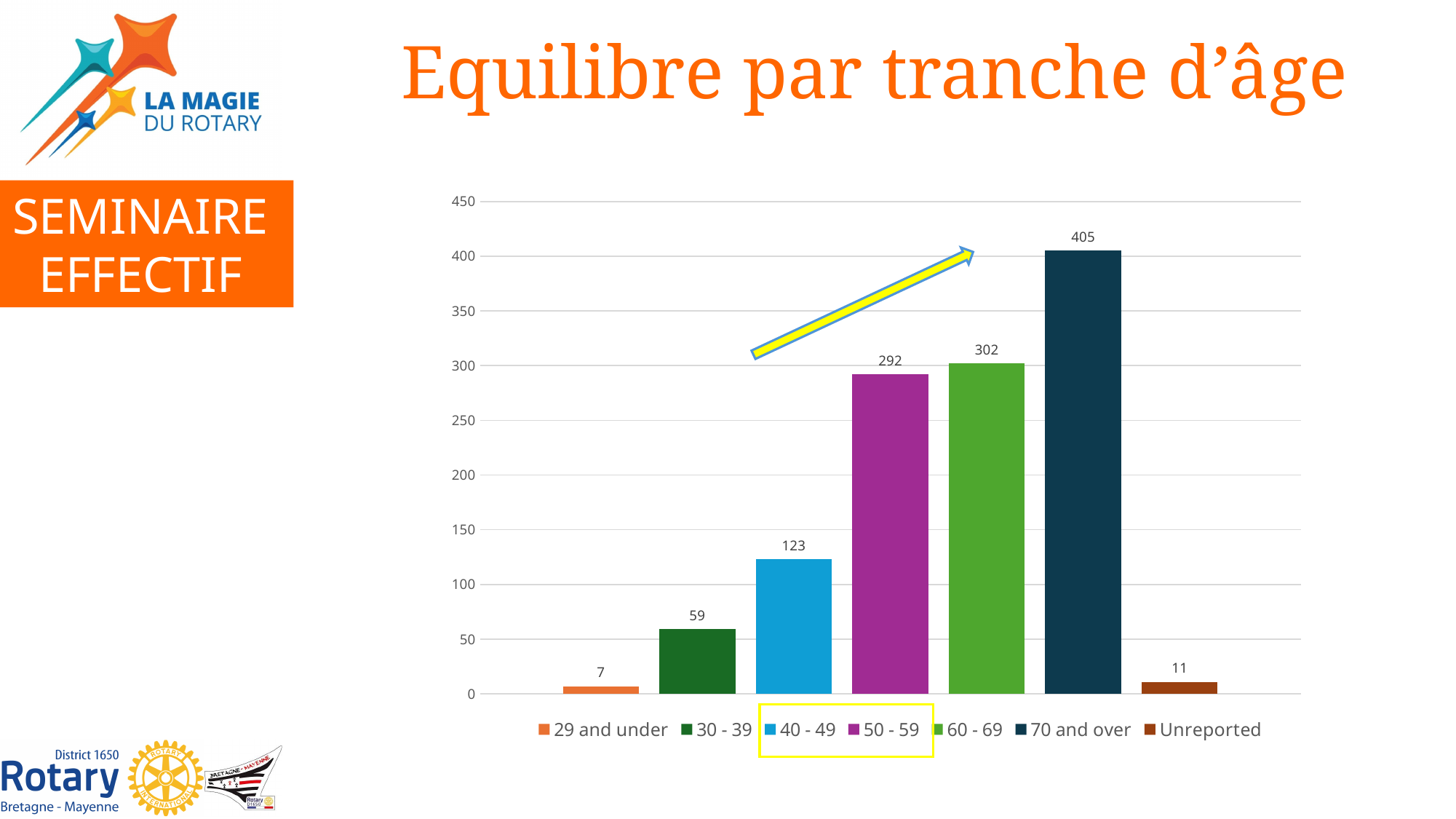
What is the difference between the values for 70 and over and 60 - 69? 103 Which is larger, the value for 30 - 39 or the value for 40 - 49? 40 - 49 What is the difference between the values for 50 - 59 and 40 - 49? 169 Is the value for 60 - 69 greater or less than 250? greater How many categories are shown in the chart? 7 Which age group has the highest value? 70 and over What is the value for the 40 - 49 age group? 123 Which category has the lowest value? 29 and under What is the value for the 70 and over age group? 405 What is the value for the Unreported category? 11 What kind of chart is shown on the slide? bar chart What is the title of the slide containing the chart? Equilibre par tranche d’âge